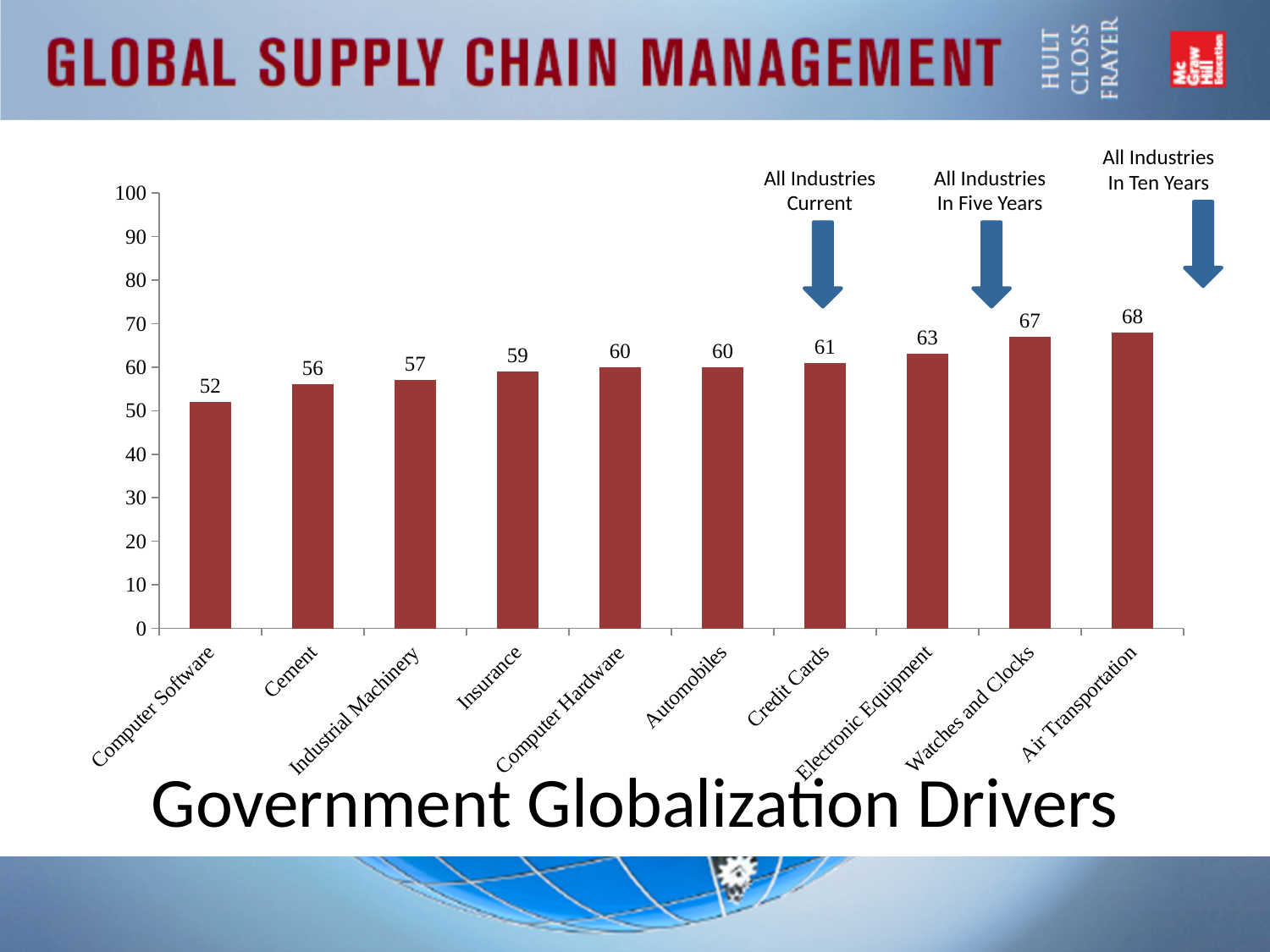
Which is larger, the value for Insurance or the value for Industrial Machinery? Insurance What kind of chart is shown on the slide? bar chart Which category has the highest value? Air Transportation What is the value for Watches and Clocks? 67 Is the value for Cement greater or less than 50? greater Which category has the lowest value? Computer Software What is the value for Computer Software? 52 How many categories are shown on the x axis? 10 Do the values rise or fall from left to right along the x axis? rise What is the value for Electronic Equipment? 63 What is the difference between the values for Air Transportation and Computer Software? 16 What is the difference between the values for Credit Cards and Cement? 5